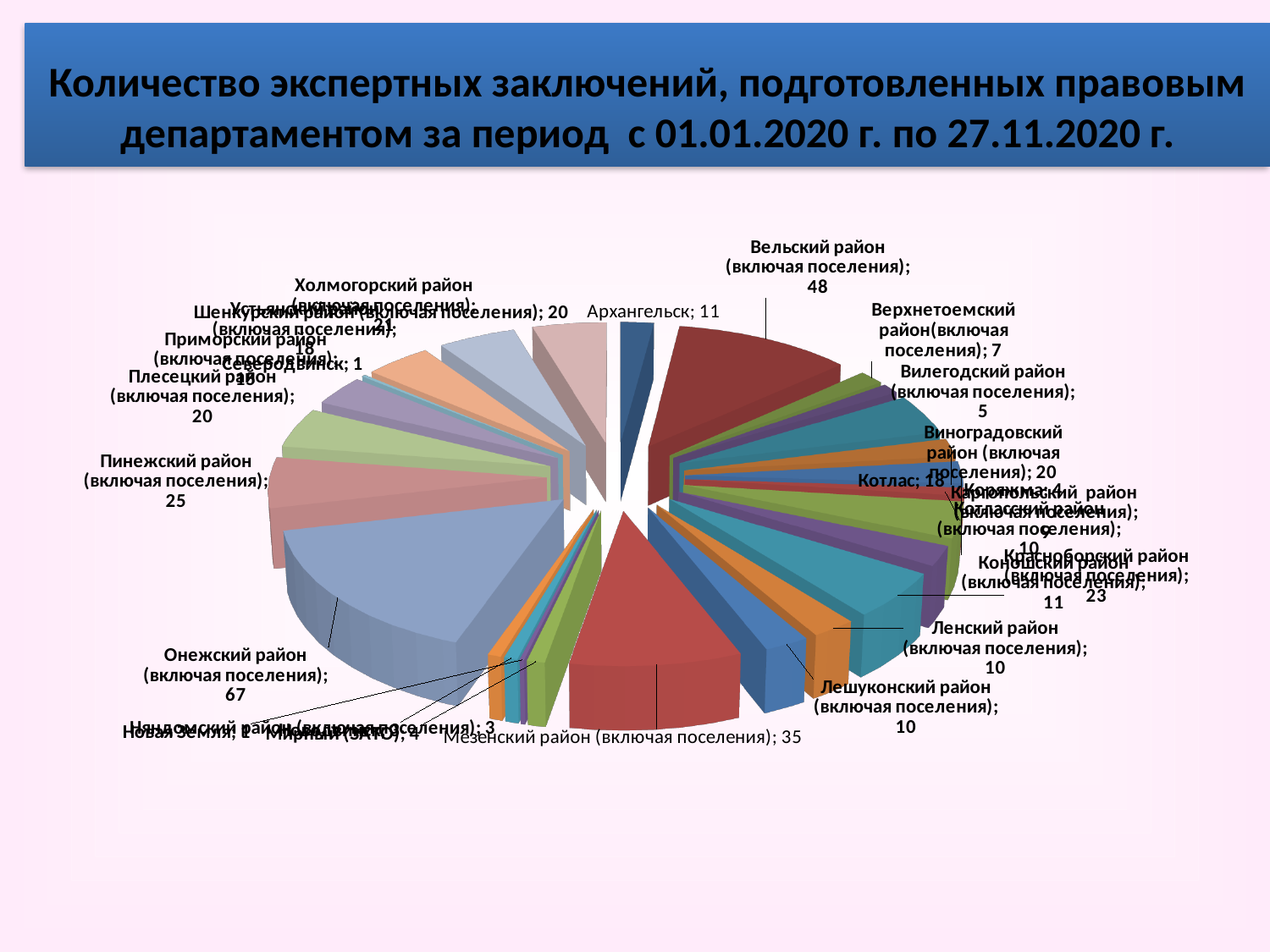
What is the value for Котлас? 18 What is the difference between the values for Мезенский район (включая поселения) and Архангельск? 24 What is the value for Красноборский район (включая поселения)? 23 What is the value for Мезенский район (включая поселения)? 35 What is the difference between the values for Онежский район (включая поселения) and Вельский район (включая поселения)? 19 What is the value for Архангельск? 11 What is the value for Онежский район (включая поселения)? 67 Which category has the largest slice in the pie chart? Онежский район (включая поселения) What is the value for Вельский район (включая поселения)? 48 What kind of chart is shown on the slide? pie chart Which is larger, the value for Пинежский район (включая поселения) or the value for Холмогорский район (включая поселения)? Пинежский район (включая поселения) What is the title of the chart on the slide? Количество экспертных заключений, подготовленных правовым департаментом за период с 01.01.2020 г. по 27.11.2020 г.